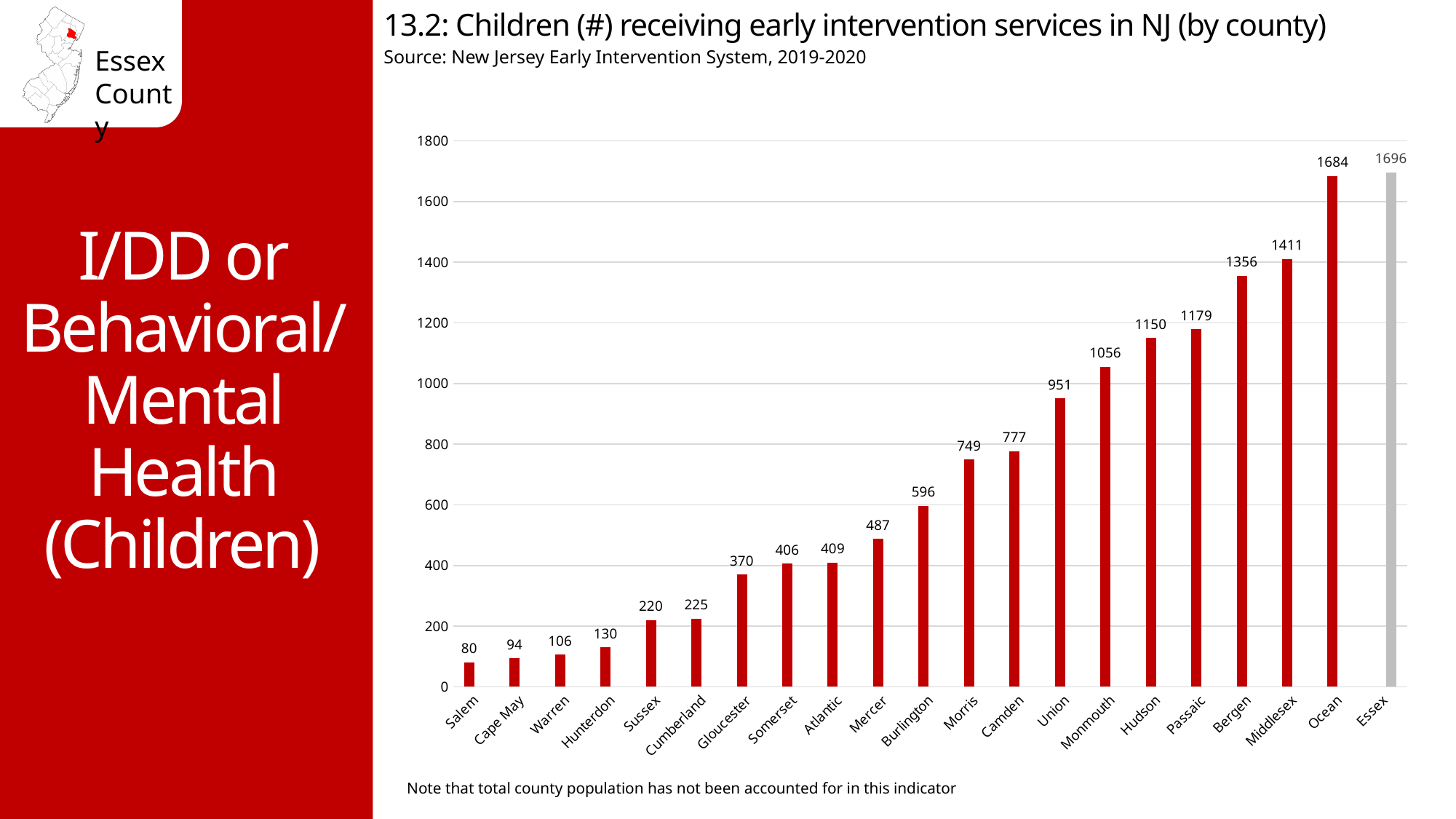
What is the difference between the values for Essex and Ocean? 12 How many children received early intervention services in Essex County? 1696 Which county has the lowest number of children receiving early intervention services? Salem What is the difference between the values for Bergen and Passaic? 177 How many counties are shown on the x axis of the chart? 21 Which county has a larger value, Morris or Camden? Camden Which county has the highest number of children receiving early intervention services? Essex What is the value shown for Hudson County? 1150 What is the value shown for Gloucester County? 370 What kind of chart is shown on the slide? Bar chart Is the value for Union greater or less than 1000? less Do the values rise or fall moving from left to right along the x axis? Rise